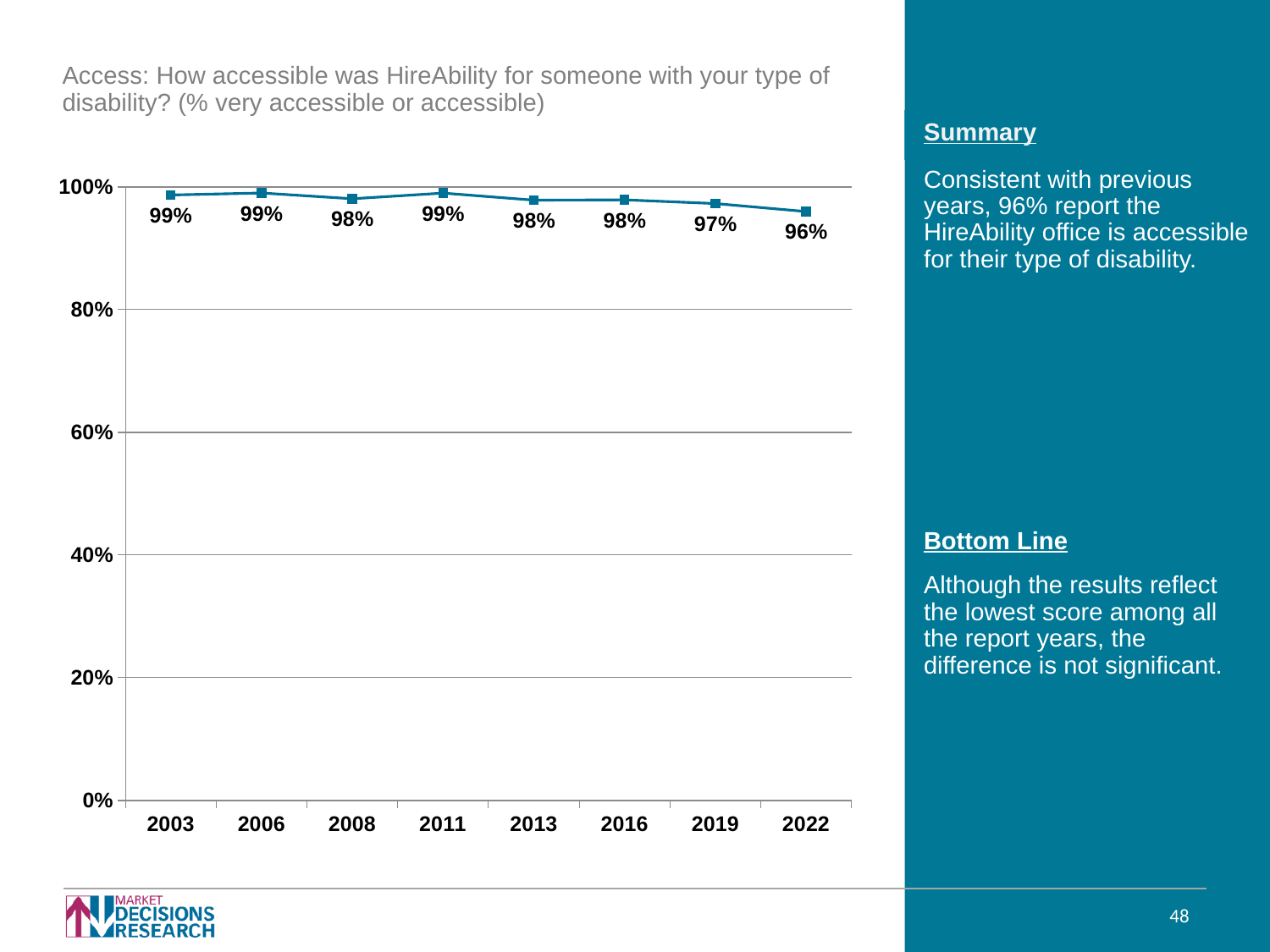
What is the value shown for 2013? 98% What kind of chart is shown on the slide? line chart What is the value shown for 2003? 99% What is the value shown for 2019? 97% How many years are plotted on the chart? 8 What is the difference between the 2011 value and the 2019 value? 2% Is the value for 2022 greater or less than 80%? greater Do the values generally rise or fall from 2011 to 2022? fall What percentage reported HireAbility was accessible in 2022? 96% What is the difference between the 2003 value and the 2022 value? 3% Which is larger, the value for 2016 or the value for 2022? 2016 Which year has the lowest value on the chart? 2022